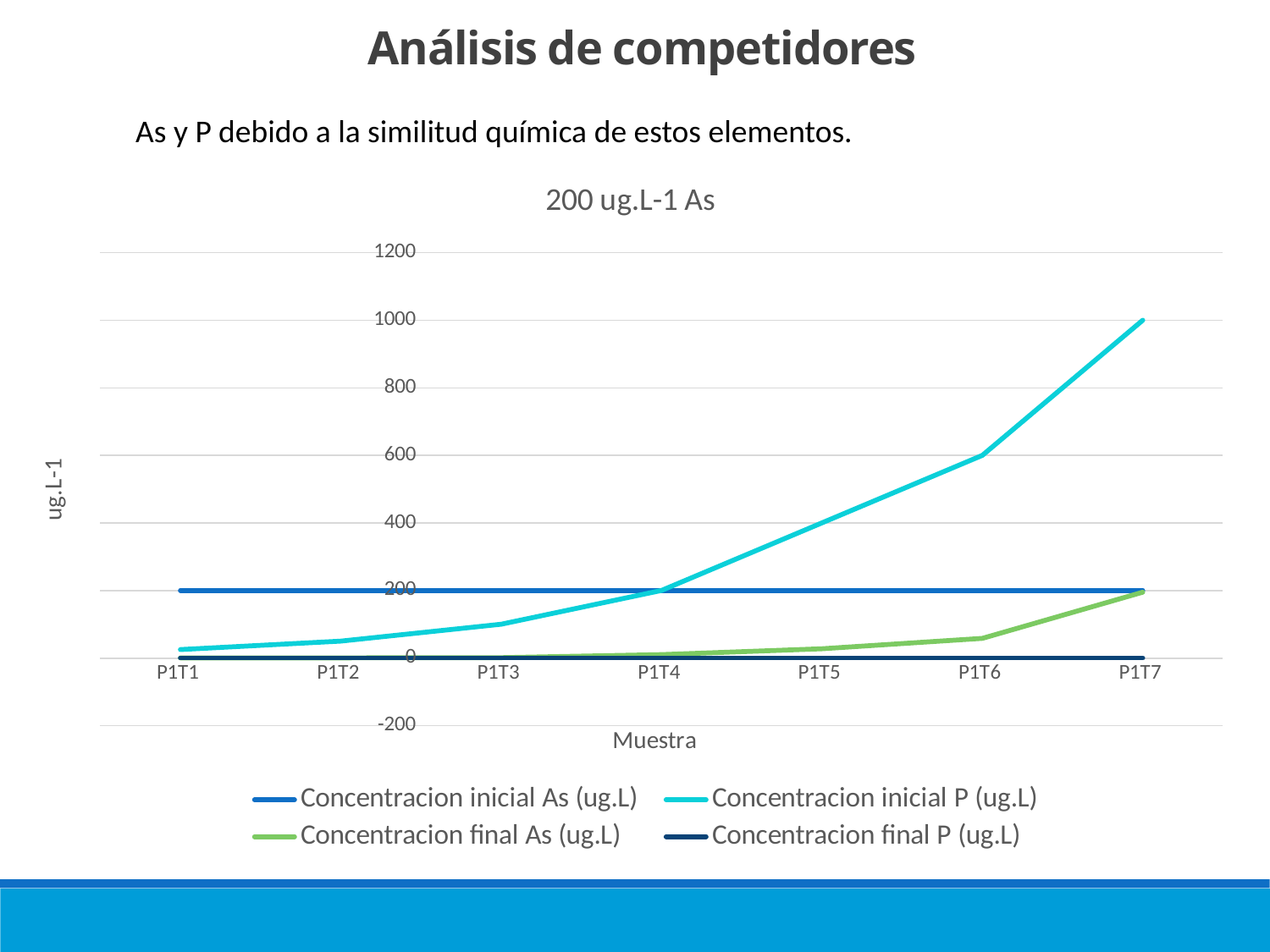
What is the value of Concentracion inicial P (ug.L) at P1T7? 1000 Is the value for Concentracion inicial P (ug.L) at P1T3 greater or less than 200? less What is the difference between Concentracion inicial P (ug.L) at P1T7 and at P1T6? 400 How many samples (Muestra) are plotted along the x axis? 7 How many series does the legend list? 4 At which sample is Concentracion inicial P (ug.L) highest? P1T7 At P1T5, which is larger: Concentracion inicial P (ug.L) or Concentracion inicial As (ug.L)? Concentracion inicial P (ug.L) What is the value of Concentracion inicial As (ug.L) at P1T1? 200 What is the value of Concentracion inicial P (ug.L) at P1T6? 600 Does Concentracion inicial P (ug.L) rise or fall from P1T1 to P1T7? rise What kind of chart is shown on the slide? line chart What is the title of the chart? 200 ug.L-1 As